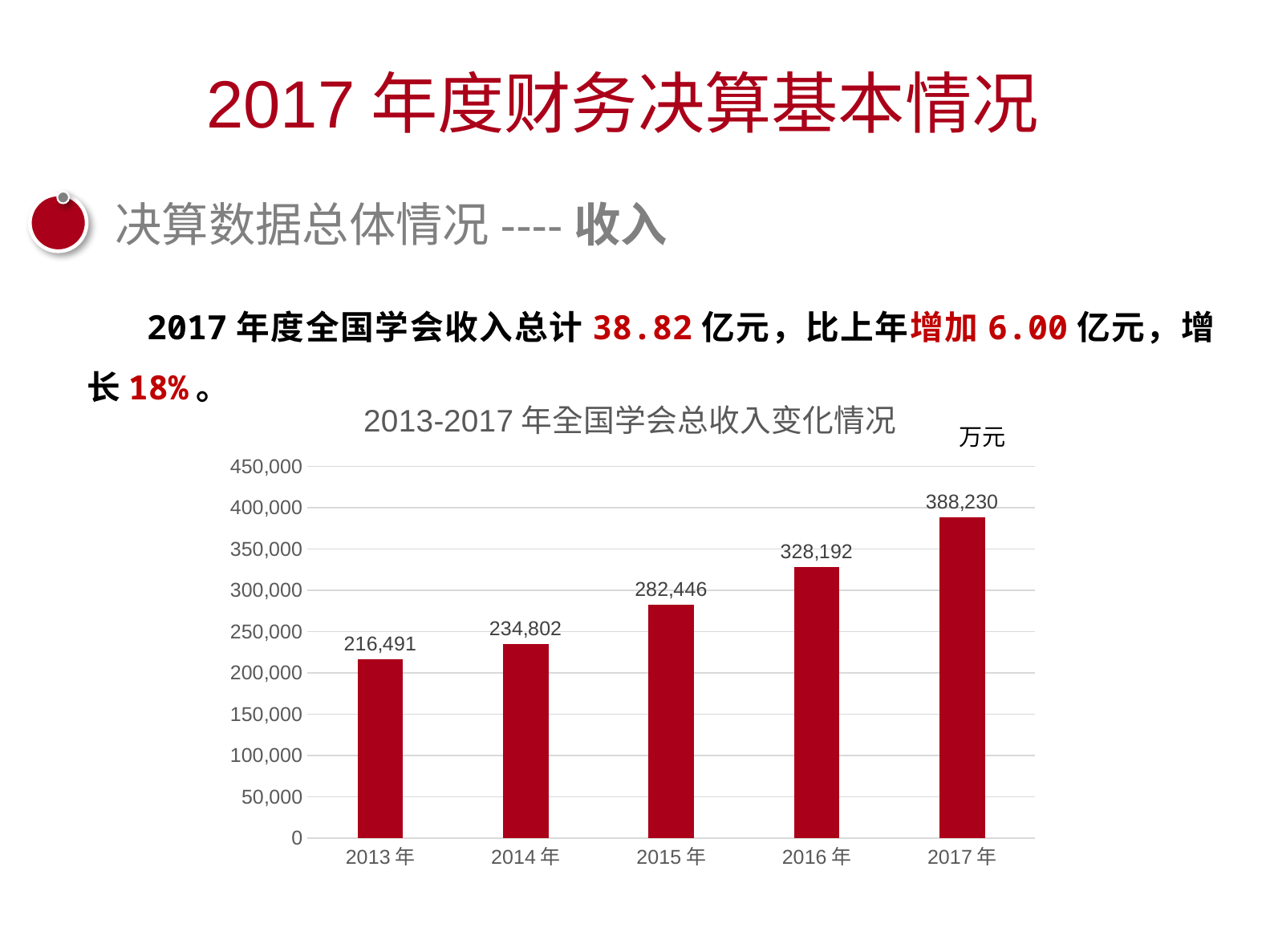
Which year has the highest value? 2017年 What is the value for 2013年? 216,491 Which year has the lowest value? 2013年 What is the difference between the values for 2015年 and 2014年? 47,644 Do the values rise or fall from 2013年 to 2017年? rise How many years are shown on the x axis? 5 Is the value for 2016年 greater or less than 300,000? greater What is the difference between the values for 2017年 and 2016年? 60,038 What is the value for 2017年? 388,230 Which is larger, the value for 2014年 or the value for 2015年? 2015年 What kind of chart is shown on the slide? bar chart What is the value for 2016年? 328,192